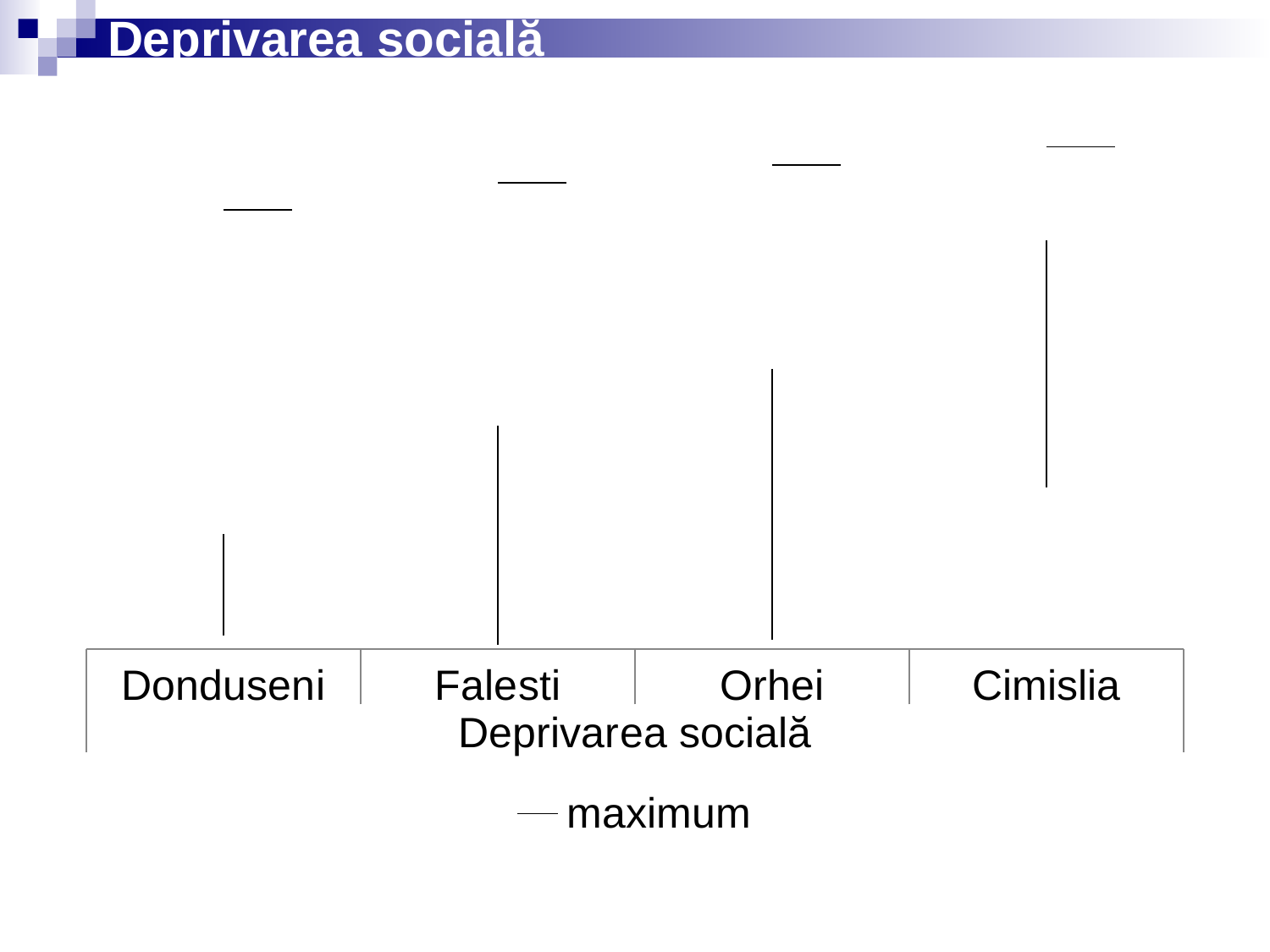
Which has a higher 'maximum' marker, Falesti or Orhei? Orhei How many categories are shown on the x axis of the chart? 4 Which category has the lowest 'maximum' marker in the chart? Donduseni What is the name of the series listed in the chart legend? maximum Which has a higher 'maximum' marker, Donduseni or Cimislia? Cimislia Do the 'maximum' markers rise or fall moving from Donduseni to Cimislia along the x axis? rise Which category is listed first on the x axis of the chart? Donduseni Which category has the highest 'maximum' marker in the chart? Cimislia How many series does the chart legend list? 1